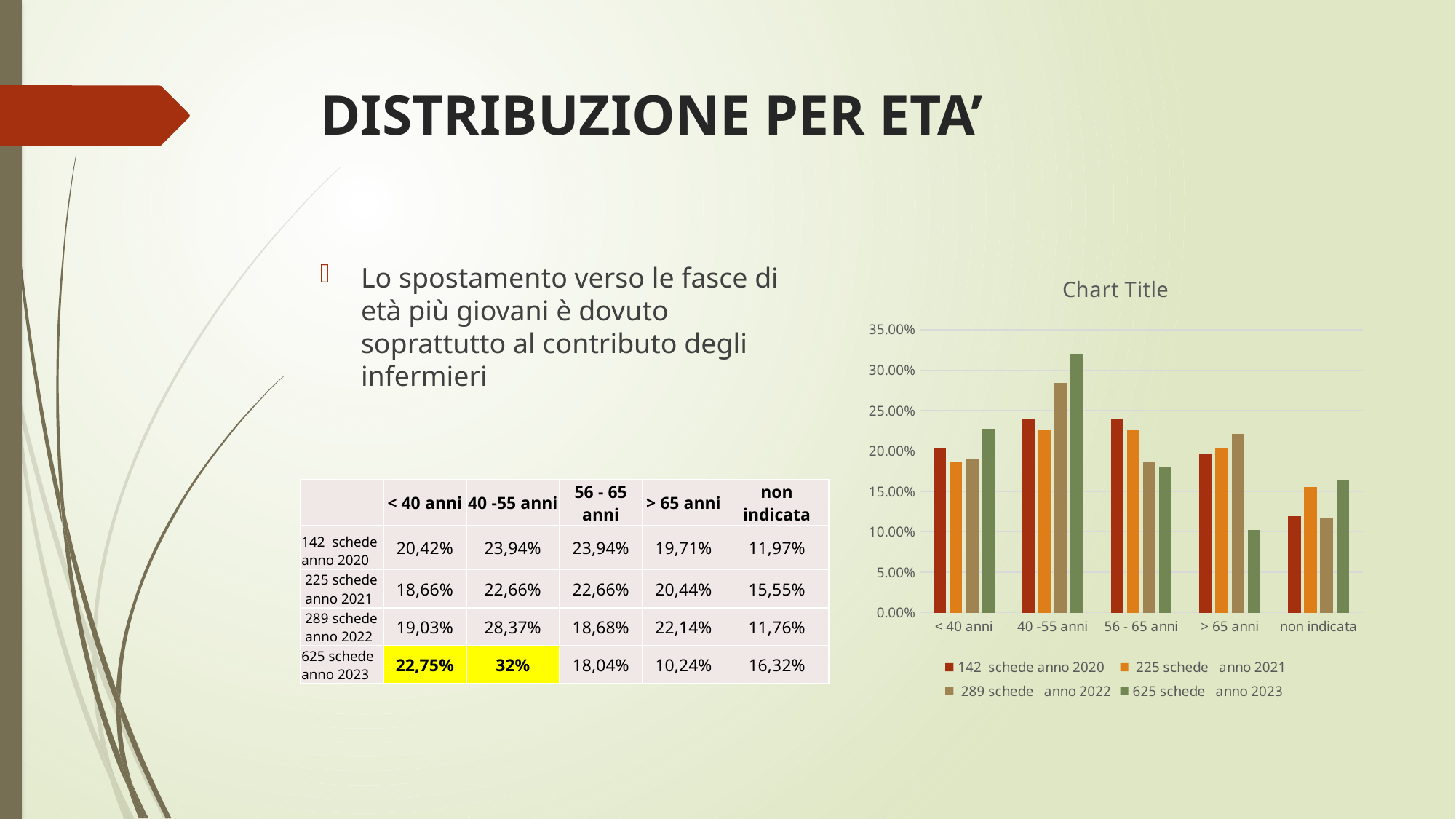
In the 'non indicata' category, which is larger: the value for '142 schede anno 2020' or for '225 schede anno 2021'? 225 schede anno 2021 What is the value for '625 schede anno 2023' in the '40 -55 anni' category? 32% Is the value for '625 schede anno 2023' in the '> 65 anni' category greater or less than 15.00%? less How many age categories are shown on the x axis of the chart? 5 How many series does the chart legend list? 4 In the '40 -55 anni' category, what is the difference between the value for '625 schede anno 2023' and the value for '142 schede anno 2020'? 8,06% What kind of chart is shown on the slide? bar chart For the series '625 schede anno 2023', which age category has the highest value? 40 -55 anni Is the value for '625 schede anno 2023' in the '40 -55 anni' category greater or less than 30.00%? greater What is the value for '289 schede anno 2022' in the '40 -55 anni' category? 28,37% What is the title shown above the chart? Chart Title For the series '625 schede anno 2023', which age category has the lowest value? > 65 anni